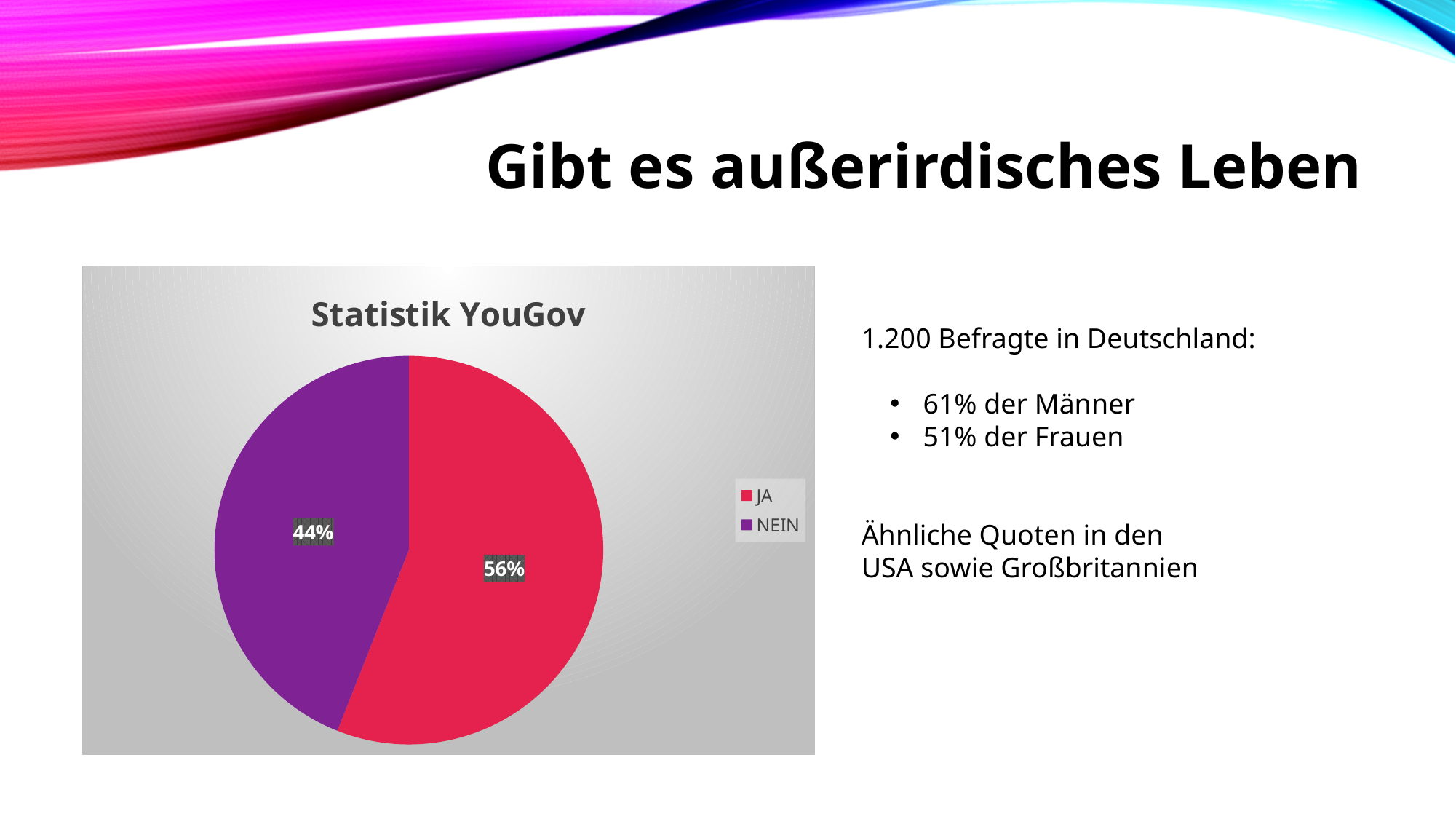
What is the title of the chart? Statistik YouGov What kind of chart is shown on the slide? pie chart How many entries does the legend list? 2 What is the difference in percentage points between the JA and NEIN slices? 12 What share of the pie does the JA slice represent? 56% What share of the pie does the NEIN slice represent? 44% What colour is the NEIN slice in the pie chart? purple Which slice is the smallest in the pie chart? NEIN How many slices does the pie chart have? 2 Which slice is the largest in the pie chart? JA Which is larger, the JA slice or the NEIN slice? JA